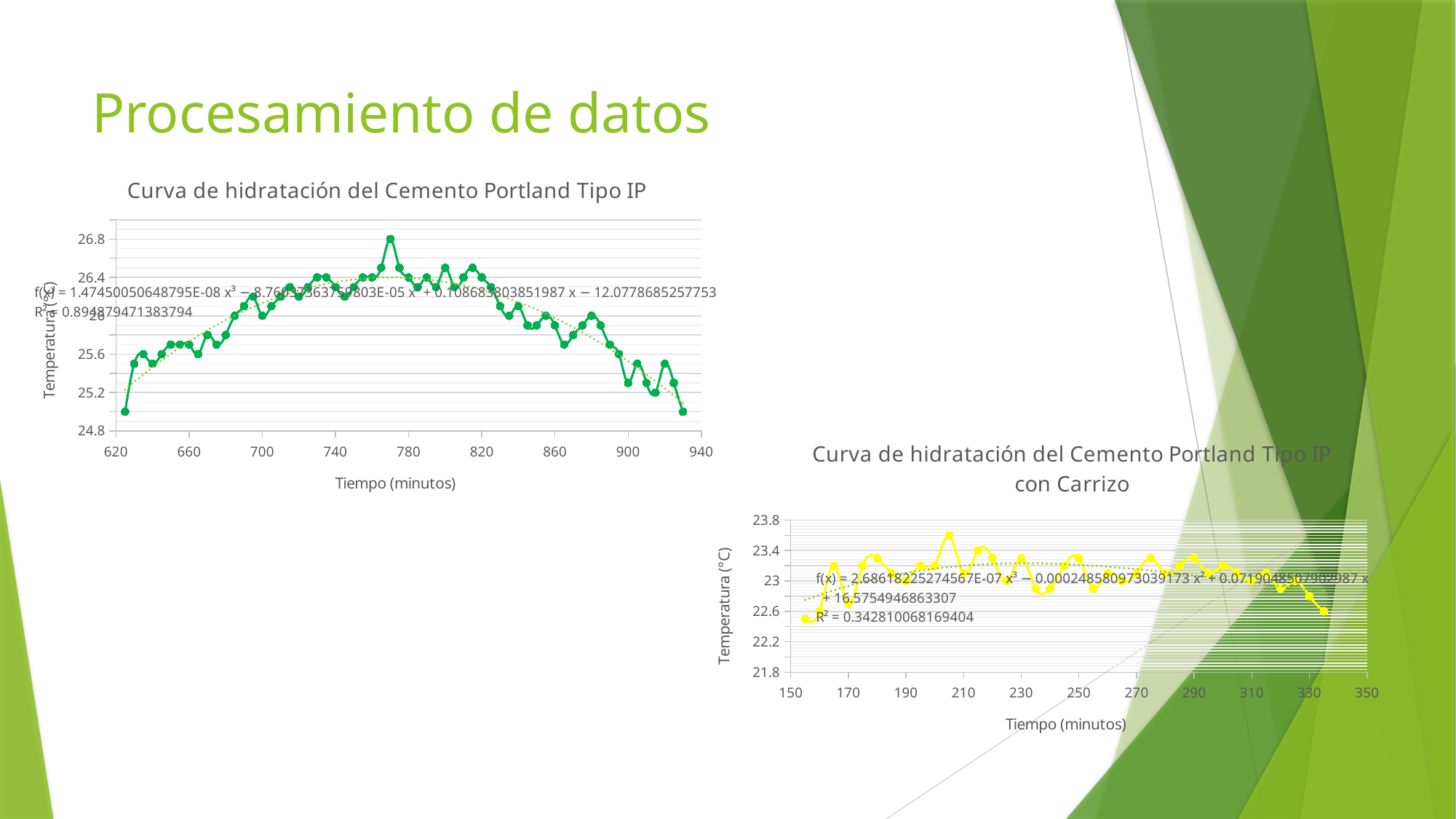
In the left chart, does the temperature rise or fall between 620 and 700 minutes? rise What is the x-axis label of the right chart (con Carrizo)? Tiempo (minutos) What is the R² value shown on the left chart? 0.894879471383794 What kind of chart is the 'Curva de hidratación del Cemento Portland Tipo IP' chart on the left? line chart In the right chart (con Carrizo), does the temperature rise or fall between 310 and 335 minutes? fall In the right chart (con Carrizo), is the peak temperature around 205 minutes greater or less than 23.4? greater In the left chart, is the highest temperature reached (around 770 minutes) greater or less than 26.4? greater What kind of chart is the 'Curva de hidratación del Cemento Portland Tipo IP con Carrizo' chart on the right? line chart In the left chart, does the temperature rise or fall between 880 and 930 minutes? fall